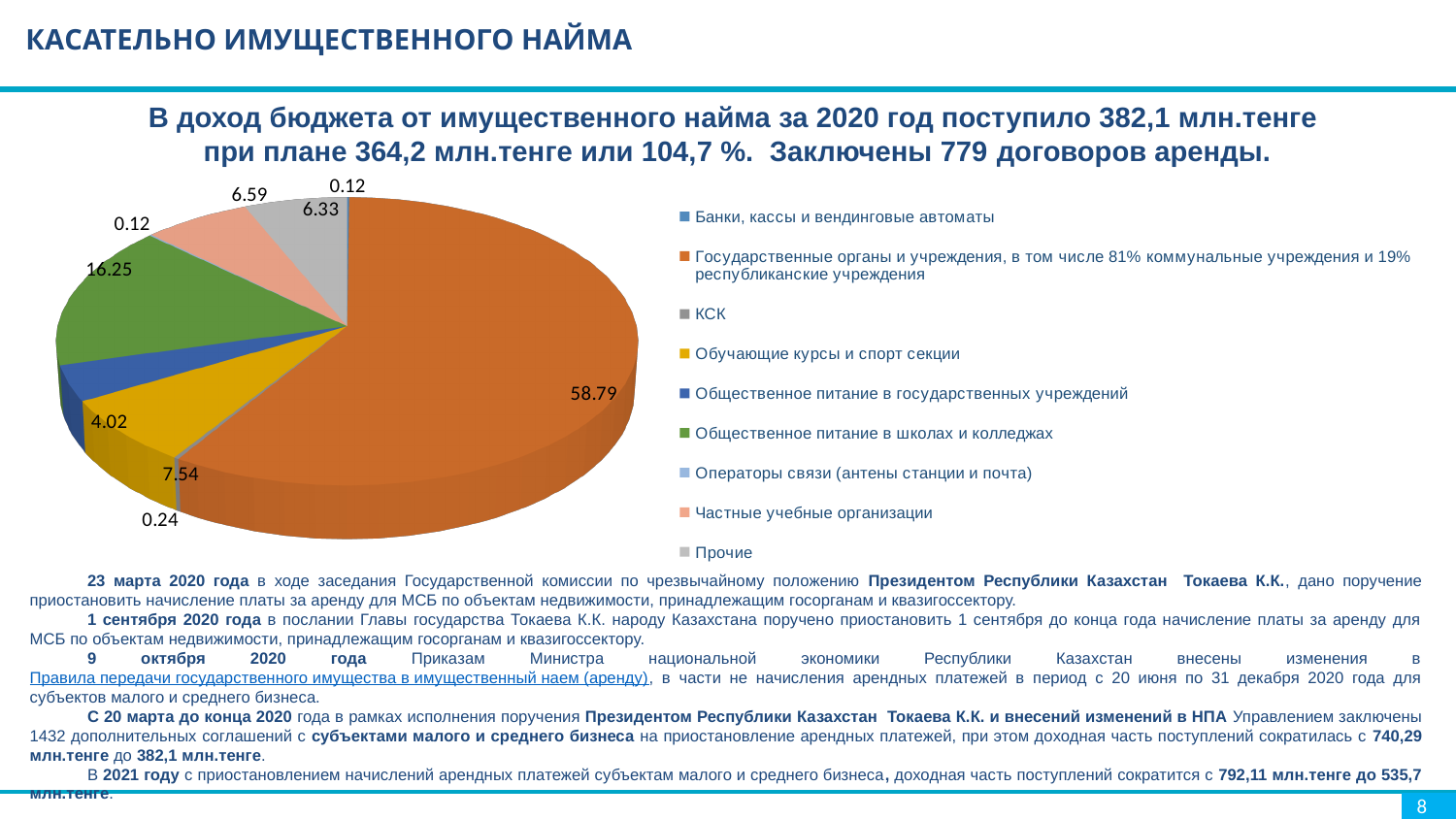
What is the value shown for the slice labelled Частные учебные организации? 6.59 What is the value shown for the slice labelled Прочие? 6.33 According to the text above the chart, how many lease agreements (договоров аренды) were concluded? 779 What is the value shown for the dark blue slice (Общественное питание в государственных учреждениях)? 4.02 What is the value shown for the largest slice of the pie chart? 58.79 What is the value shown for the green slice (Общественное питание в школах и колледжах)? 16.25 How many categories does the legend of the pie chart list? 9 What is the difference between the value for Общественное питание в школах и колледжах (16.25) and the value for Обучающие курсы и спорт секции (7.54)? 8.71 Which is larger: the slice for Общественное питание в школах и колледжах or the slice for Обучающие курсы и спорт секции? Общественное питание в школах и колледжах What is the value shown for the yellow slice (Обучающие курсы и спорт секции)? 7.54 Which category has the largest share of the pie chart? Государственные органы и учреждения, в том числе 81% коммунальные учреждения и 19% республиканские учреждения What kind of chart is shown on the slide? pie chart